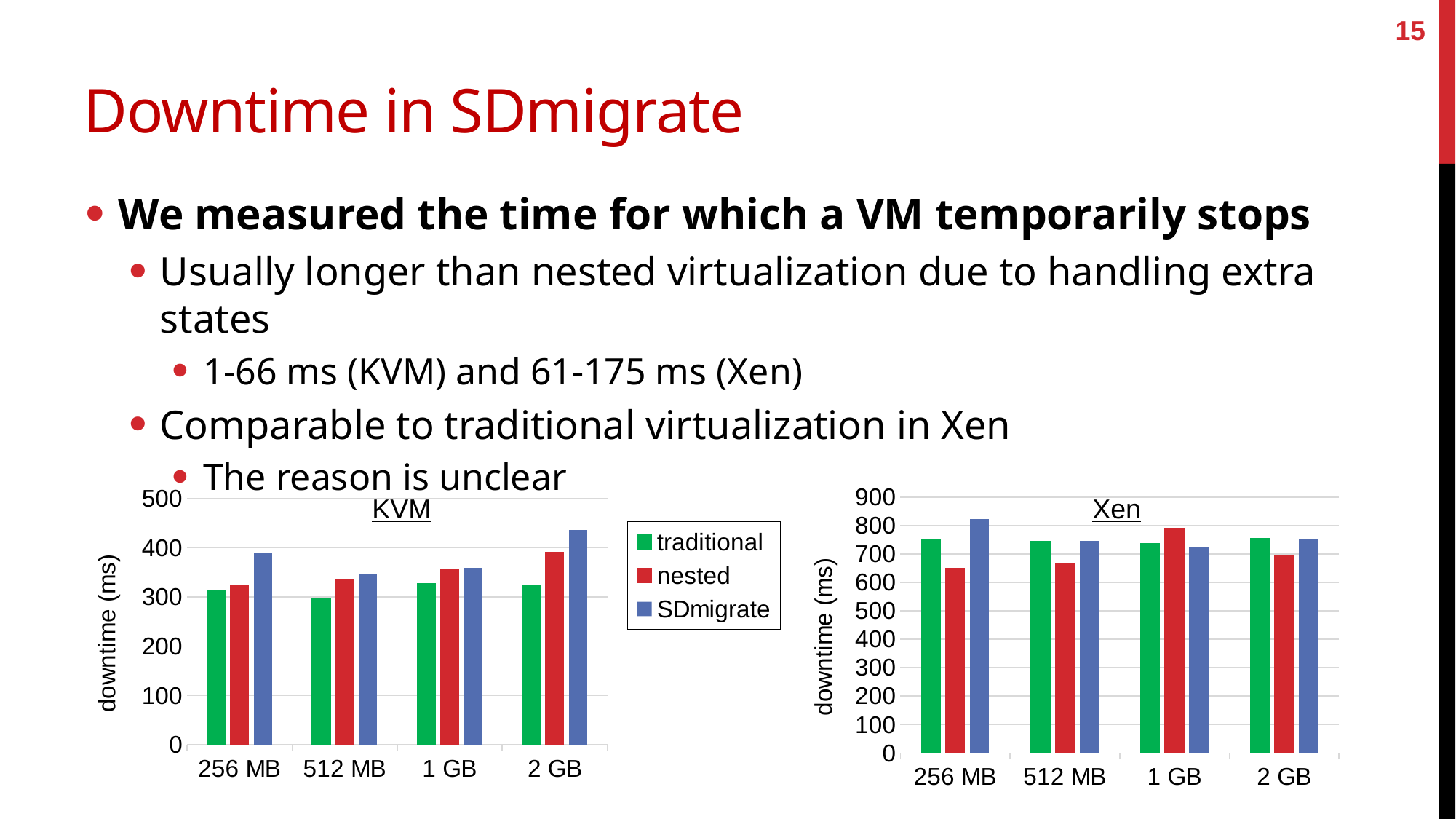
How many memory-size categories are shown on the x axis of the Xen chart? 4 In the Xen chart, which memory size has the lowest nested downtime? 256 MB In the KVM chart, which memory size has the highest SDmigrate downtime? 2 GB How many series does the legend list? 3 In the Xen chart, is the nested value for 256 MB greater or less than 700? less In the Xen chart, for 1 GB, which is larger: the nested value or the SDmigrate value? nested What is the y-axis label of the Xen chart? downtime (ms) In the KVM chart, is the SDmigrate value for 2 GB greater or less than 400? greater In the KVM chart, for 256 MB, which is larger: the traditional value or the SDmigrate value? SDmigrate What kind of chart is the KVM chart? bar chart In the Xen chart, is the SDmigrate value for 256 MB greater or less than 800? greater